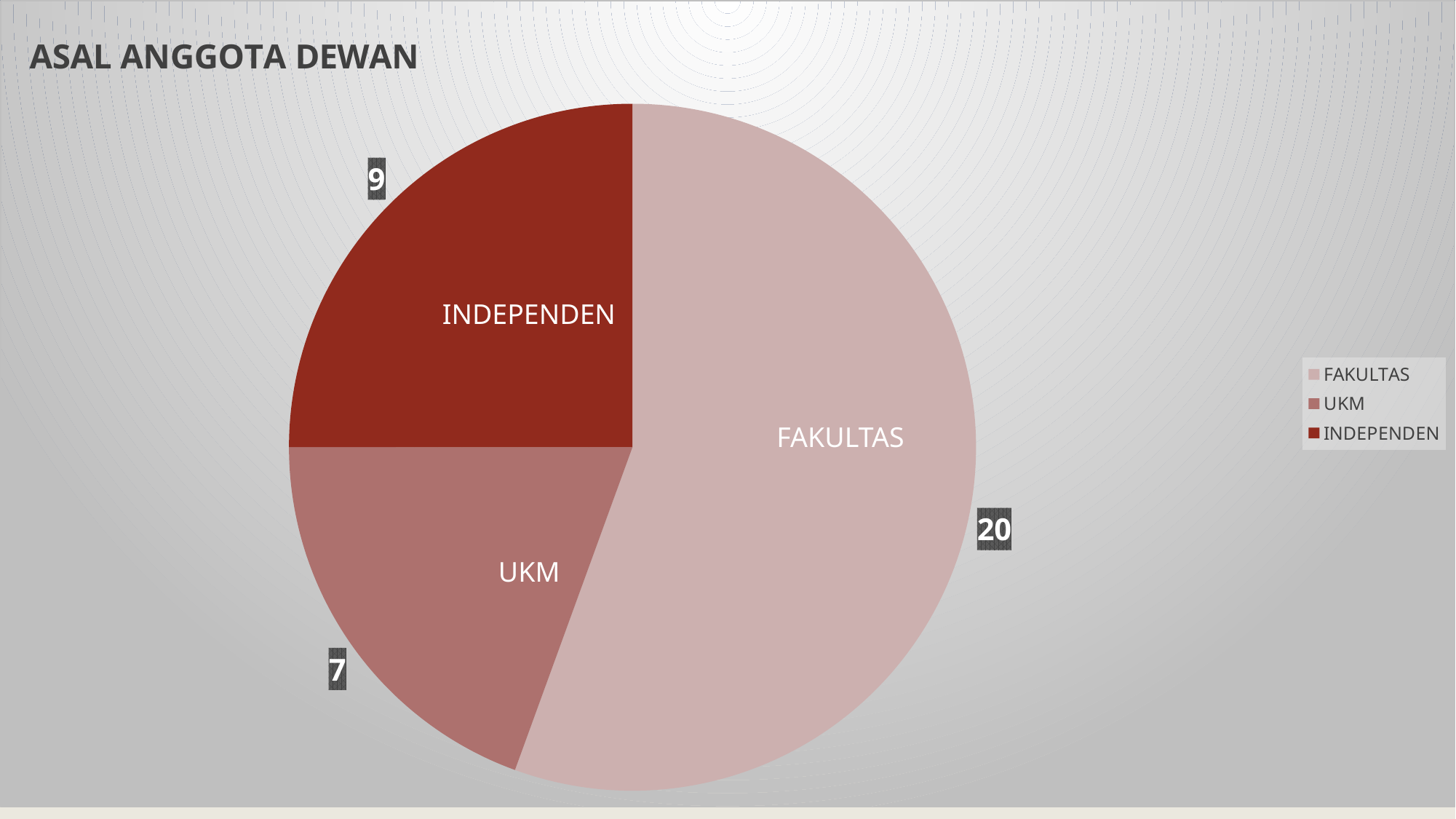
What kind of chart is shown on the slide? Pie chart How many categories are shown in the pie chart? 3 What is the difference between the values for INDEPENDEN and UKM? 2 What is the value for INDEPENDEN? 9 What share of the pie does INDEPENDEN represent? 25% What is the value for FAKULTAS? 20 Which category has the smallest slice of the pie? UKM What is the difference between the values for FAKULTAS and INDEPENDEN? 11 Which category has the largest slice of the pie? FAKULTAS Which is larger, the value for UKM or the value for INDEPENDEN? INDEPENDEN What is the title of the chart? ASAL ANGGOTA DEWAN What is the value for UKM? 7